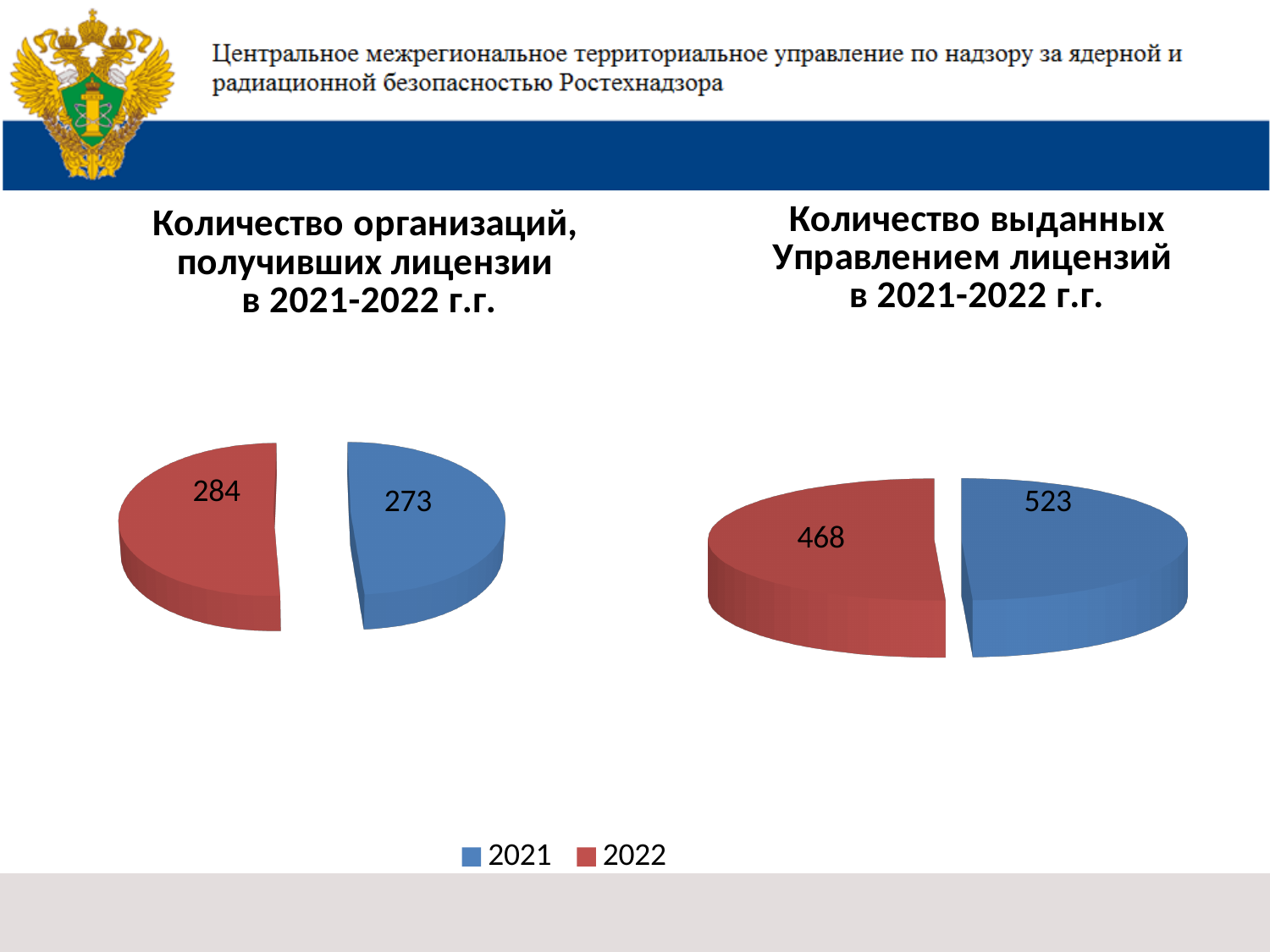
What type of chart is used on this slide? Pie chart In the right chart (licences issued by the Directorate), is the value for 2021 larger or smaller than the value for 2022? larger In the chart 'Количество выданных Управлением лицензий в 2021-2022 г.г.', what is the value for 2022? 468 Which colour represents 2022 in the legend? Red In the right chart (licences issued by the Directorate), what is the difference between the 2021 and 2022 values? 55 In the right chart (licences issued by the Directorate), which year has the smaller value? 2022 In the left chart (organisations that received licences), what is the difference between the 2022 and 2021 values? 11 In the left chart (organisations that received licences), which year has the larger value? 2022 In the chart 'Количество выданных Управлением лицензий в 2021-2022 г.г.', what is the value for 2021? 523 How many series does the legend list? 2 In the chart 'Количество организаций, получивших лицензии в 2021-2022 г.г.', what is the value for 2022? 284 In the chart 'Количество организаций, получивших лицензии в 2021-2022 г.г.', what is the value for 2021? 273